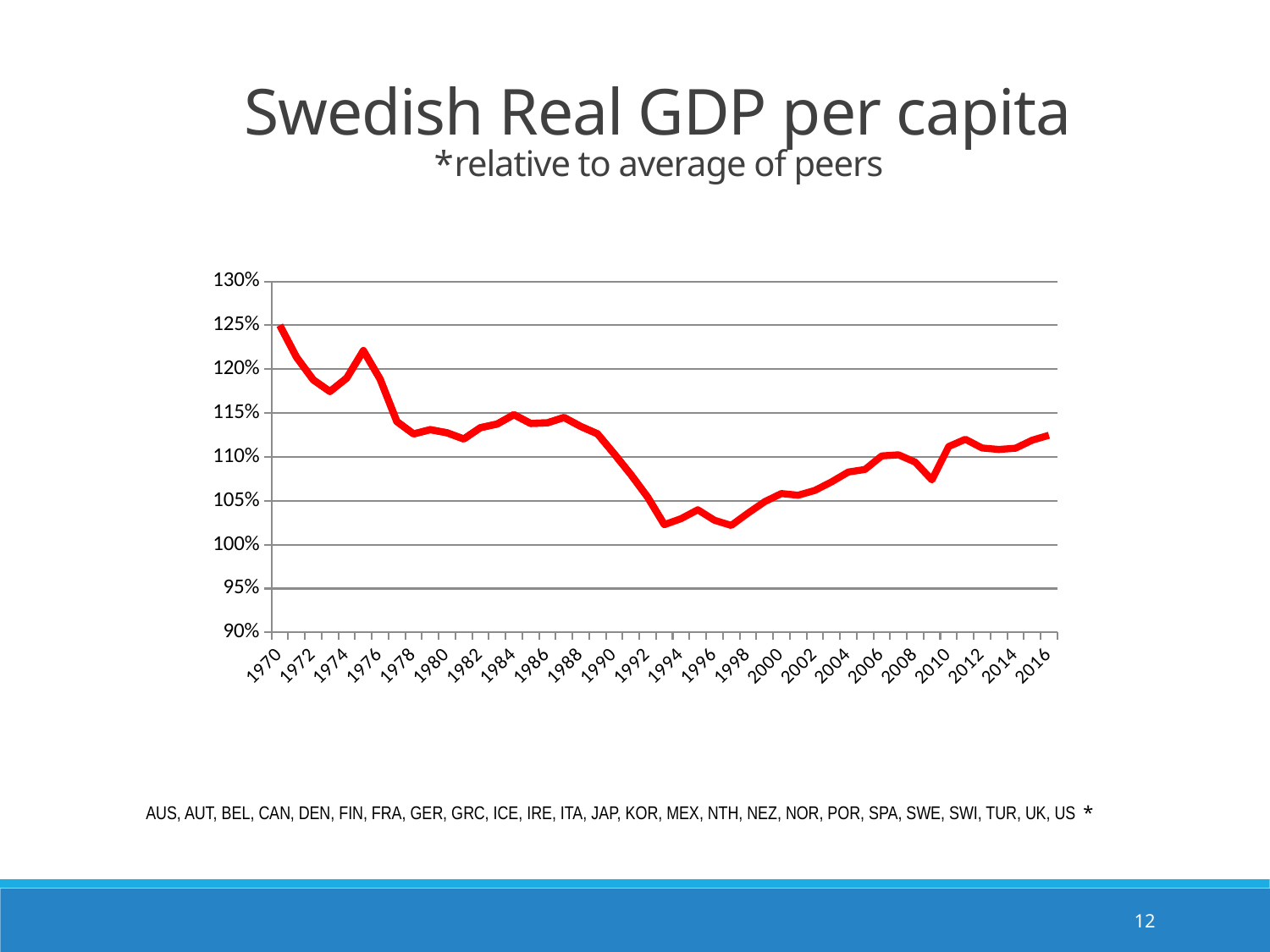
Is the value for 1993 greater or less than 105%? less Is the value for 2009 greater or less than 110%? less Is the value for 2016 greater or less than 110%? greater In which year is Swedish real GDP per capita relative to peers at its highest? 1970 What colour is the plotted line? red Which year has the larger value, 1984 or 1993? 1984 Which year has the larger value, 1970 or 2016? 1970 Does the value rise or fall between 1970 and 1993? fall What kind of chart is shown on the slide? line chart What is the title of the chart? Swedish Real GDP per capita Does the value rise or fall between 1997 and 2016? rise